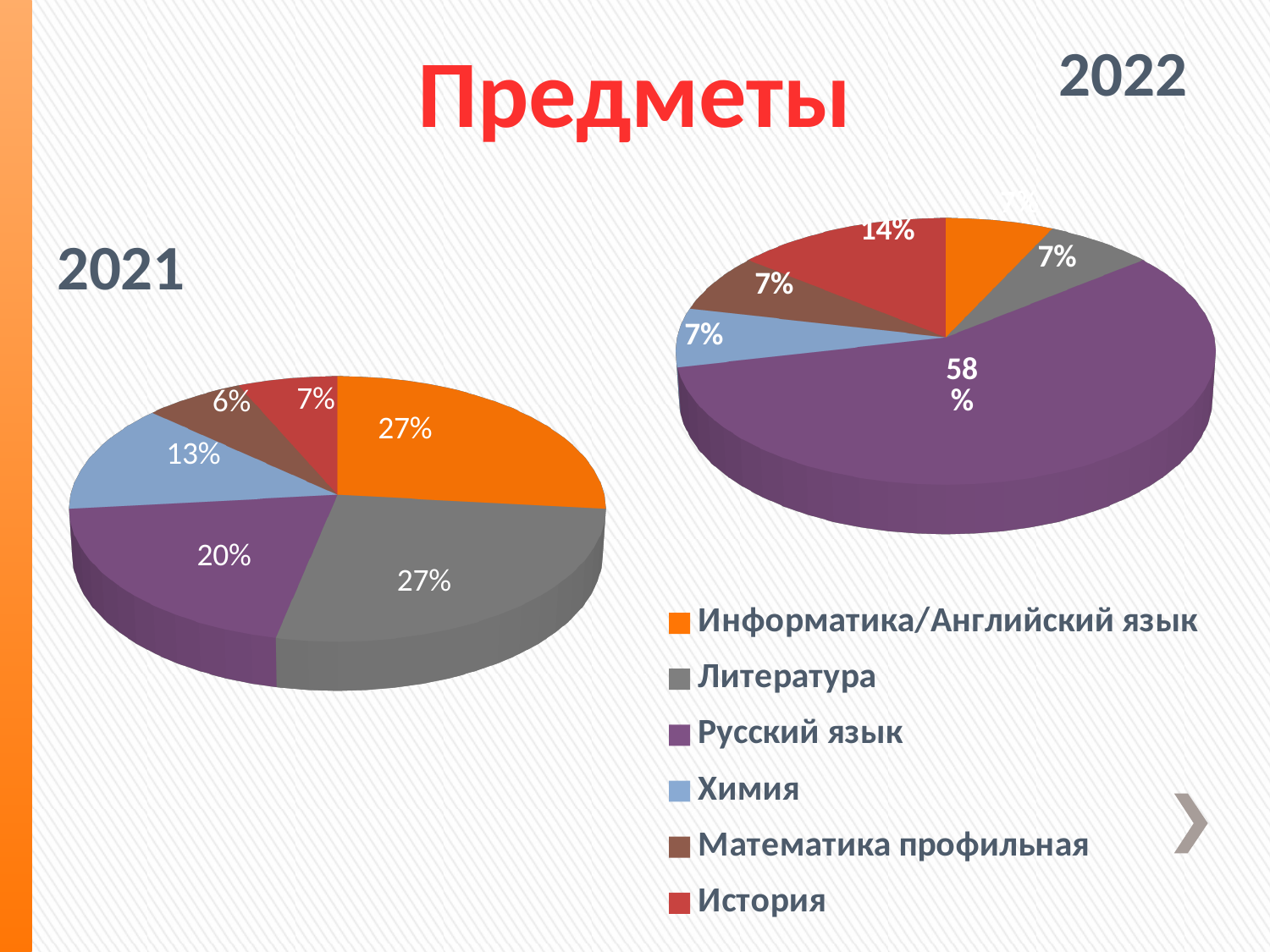
Which colour represents Химия in the legend? Light blue In the 2021 pie chart, what is the value for Русский язык? 20% In the 2022 pie chart, what is the value for История? 14% How many categories does the legend list? 6 In the 2022 pie chart, which category has the largest slice? Русский язык In the 2021 pie chart, which is larger: Литература or Русский язык? Литература In the 2021 pie chart, what is the difference between the values for Русский язык and Химия? 7% In the 2021 pie chart, what is the value for Математика профильная? 6% In the 2021 pie chart, what is the value for Химия? 13% In the 2021 pie chart, which category has the smallest slice? Математика профильная What kind of chart is the 2021 chart? Pie chart In the 2022 pie chart, what share of the pie does Русский язык take? 58%